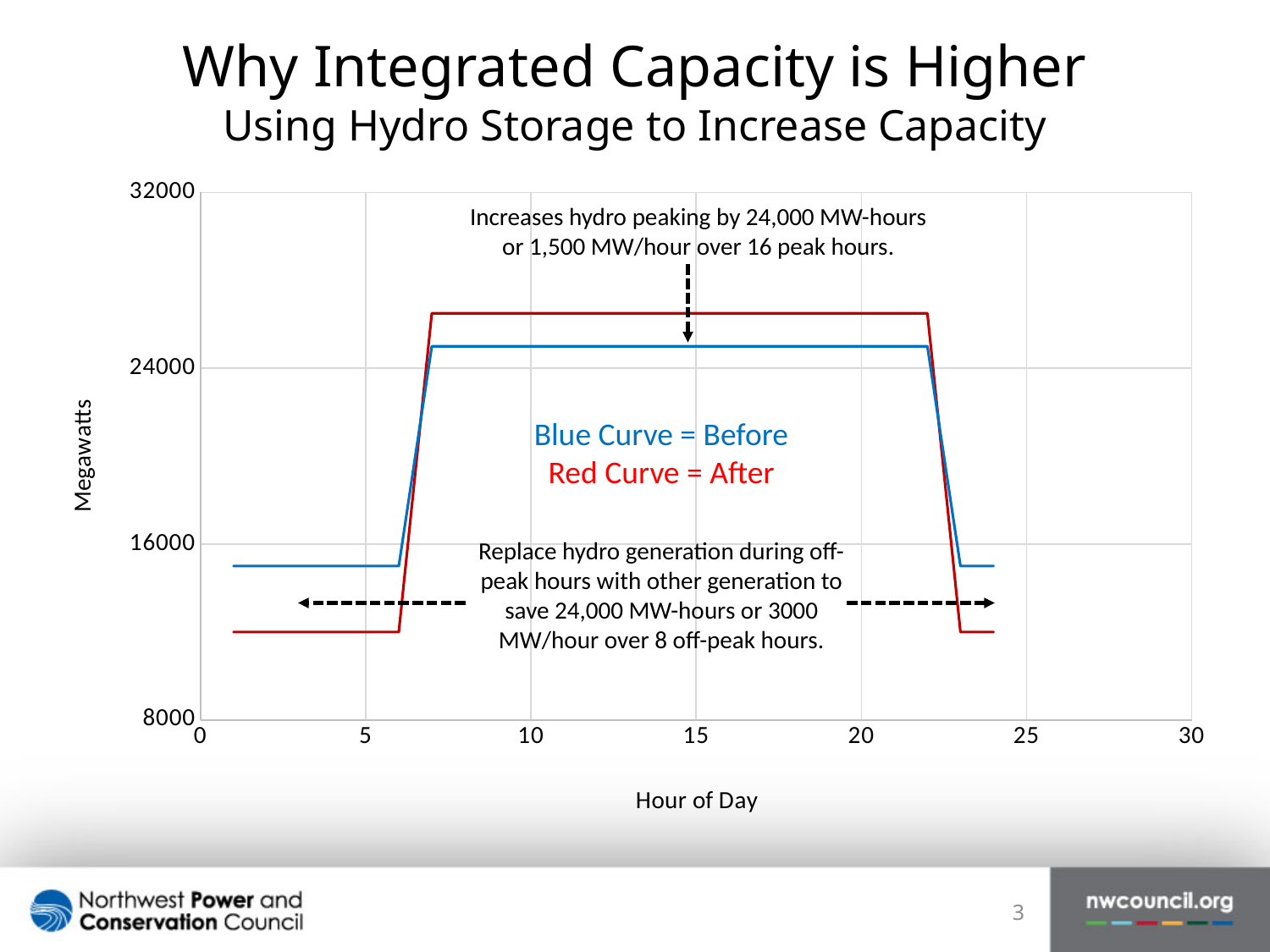
Is the value of the red curve during the peak hours (around hour 15) greater or less than 24000? greater During the peak hours (around hour 15), which curve is higher, the blue curve or the red curve? Red curve Between hour 20 and hour 25, does the red curve rise or fall? fall How many curves are plotted on the chart? 2 According to the annotation on the chart, by how much per hour does hydro peaking increase over the 16 peak hours? 1,500 MW/hour Is the value of the red curve during the off-peak hours (around hour 3) greater or less than 16000? less Between hour 5 and hour 10, does the blue curve rise or fall? rise What kind of chart is shown on the slide? line chart According to the chart's text, which colour curve represents 'After'? Red Is the value of the blue curve during the off-peak hours (around hour 3) greater or less than 16000? less What is the label on the vertical axis of the chart? Megawatts During the off-peak hours (around hour 3), which curve is higher, the blue curve or the red curve? Blue curve